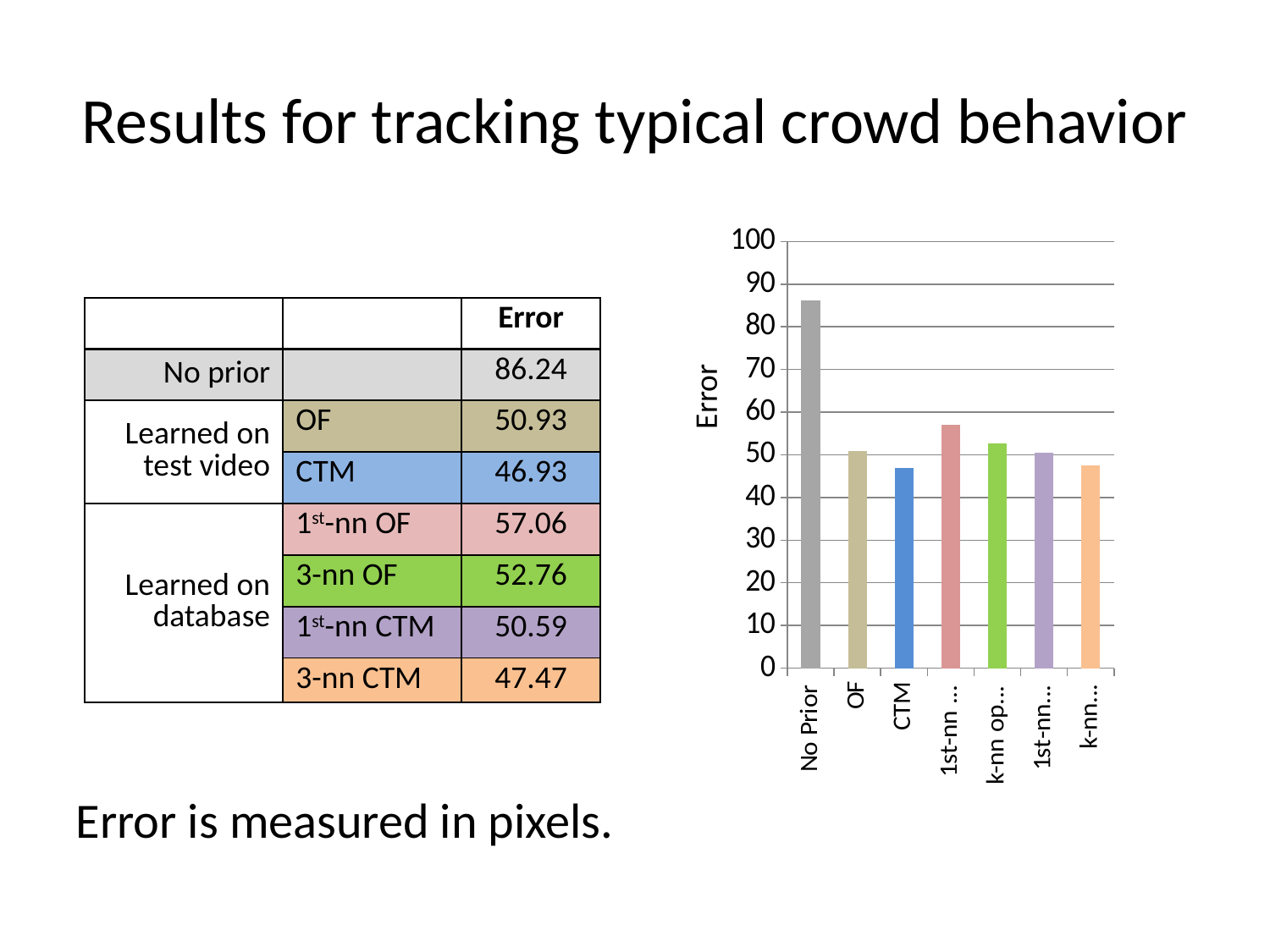
What is the label on the vertical axis of the chart? Error According to the slide, what is the error value for CTM learned on the test video? 46.93 According to the slide, what is the error value for No prior? 86.24 Which is larger, the bar for No Prior or the bar for OF? No Prior Is the value for No Prior greater or less than 80? greater What is the highest tick value shown on the vertical axis? 100 Is the value for CTM greater or less than 50? less What kind of chart is shown on the slide? bar chart How many bars does the chart have? 7 Is the value for OF greater or less than 60? less Which category has the highest bar in the chart? No Prior Which is larger, the bar for OF or the bar for CTM? OF